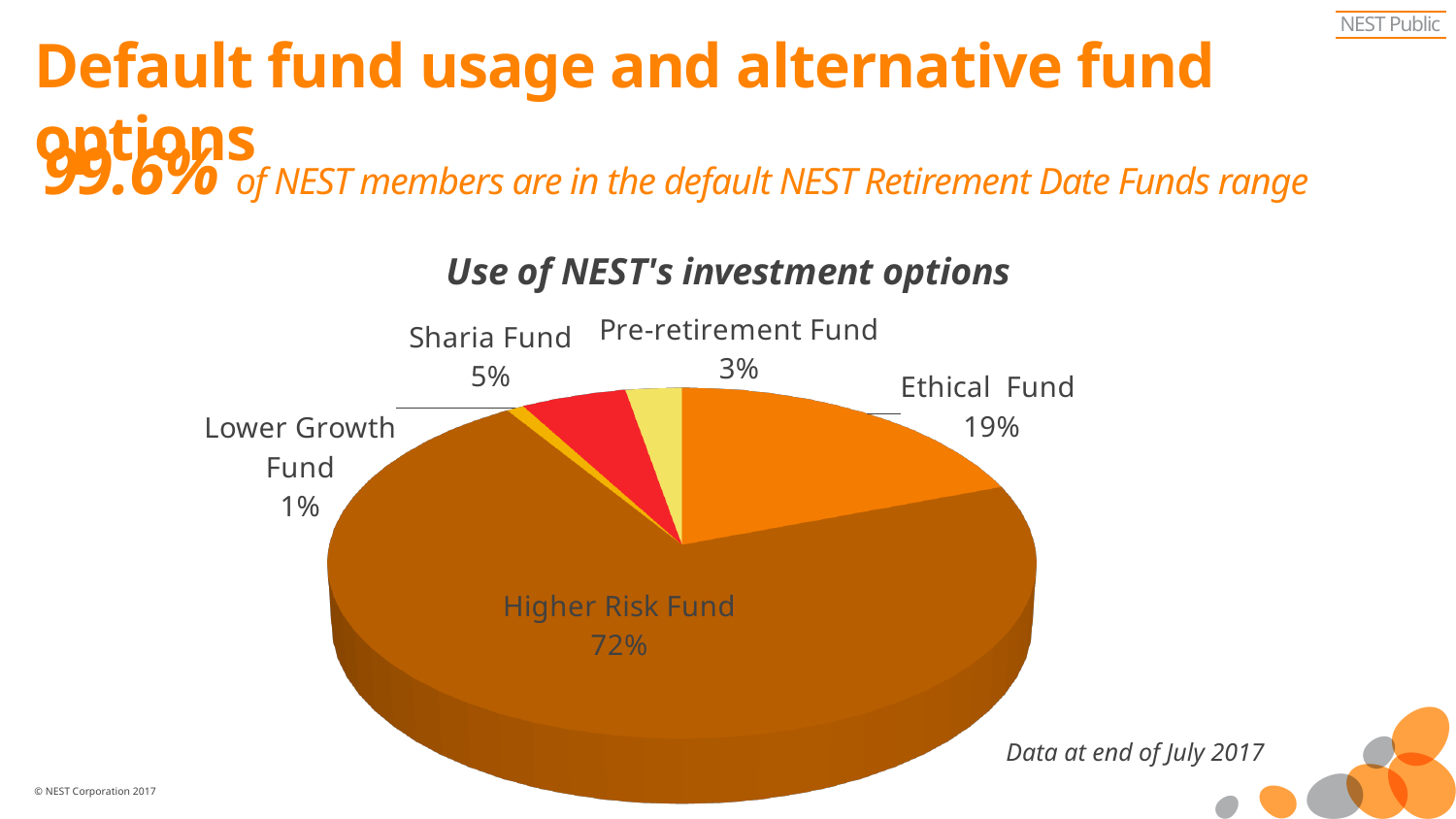
What is the title of the chart? Use of NEST's investment options What percentage is shown for the Pre-retirement Fund? 3% Which fund has the largest share of the pie? Higher Risk Fund What percentage is shown for the Lower Growth Fund? 1% What percentage is shown for the Ethical Fund? 19% How many slices does the pie chart have? 5 What share of the pie does the Higher Risk Fund have? 72% Which has a larger share, the Sharia Fund or the Pre-retirement Fund? Sharia Fund What percentage is shown for the Sharia Fund? 5% What is the difference in percentage points between the Higher Risk Fund and the Ethical Fund? 53 Which fund has the smallest share of the pie? Lower Growth Fund What type of chart is shown on the slide? Pie chart